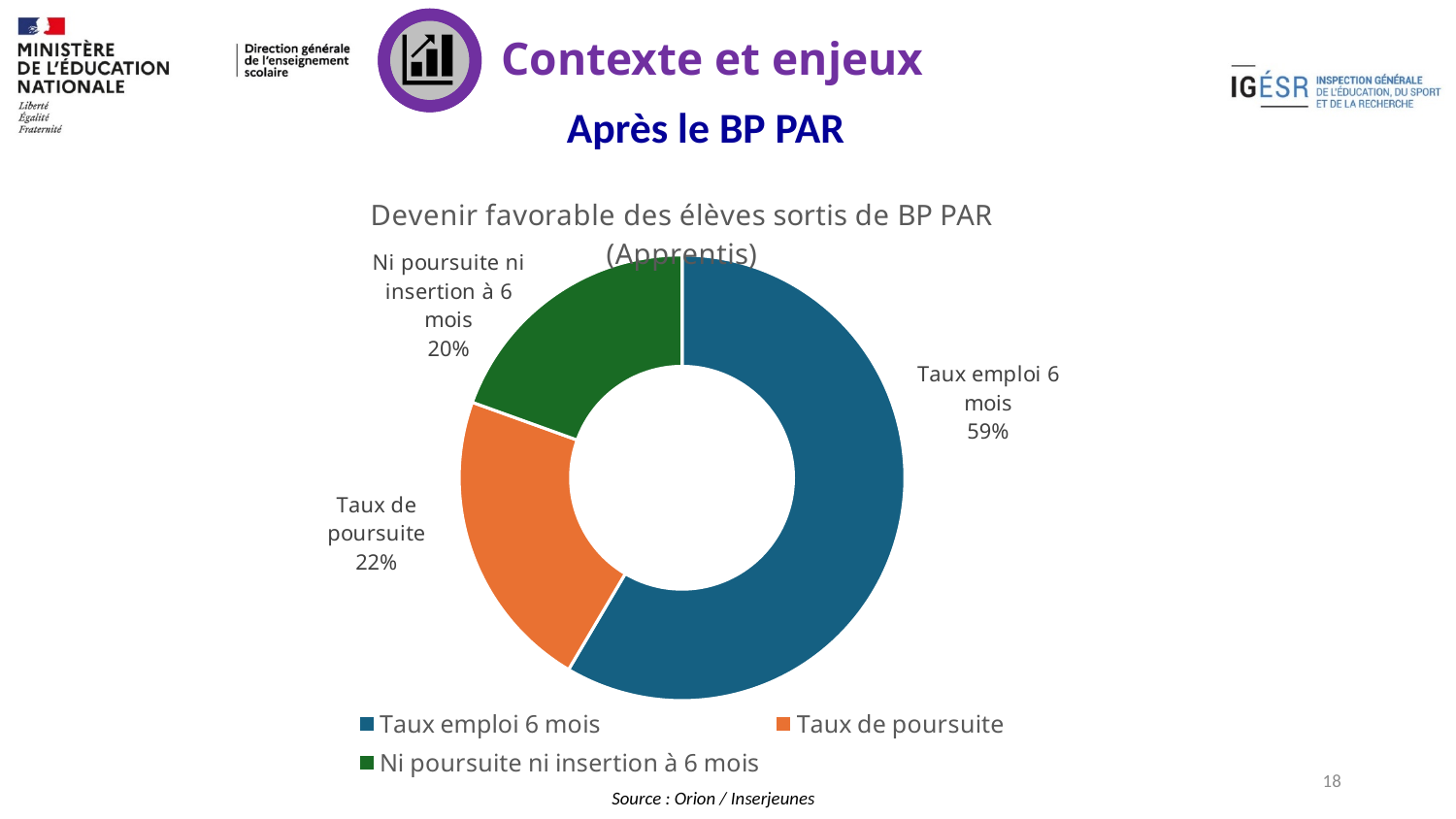
What kind of chart is shown on the slide? Pie chart (doughnut) What percentage is shown for "Taux emploi 6 mois"? 59% What is the difference in percentage points between "Taux de poursuite" and "Ni poursuite ni insertion à 6 mois"? 2 How many categories does the chart show? 3 Which category has the largest share of the chart? Taux emploi 6 mois What percentage is shown for "Ni poursuite ni insertion à 6 mois"? 20% What colour represents "Taux de poursuite" in the chart? Orange What is the title of the chart? Devenir favorable des élèves sortis de BP PAR (Apprentis) Which category has the smallest share of the chart? Ni poursuite ni insertion à 6 mois Which is larger: "Taux emploi 6 mois" or "Ni poursuite ni insertion à 6 mois"? Taux emploi 6 mois What is the difference in percentage points between "Taux emploi 6 mois" and "Taux de poursuite"? 37 What percentage is shown for "Taux de poursuite"? 22%